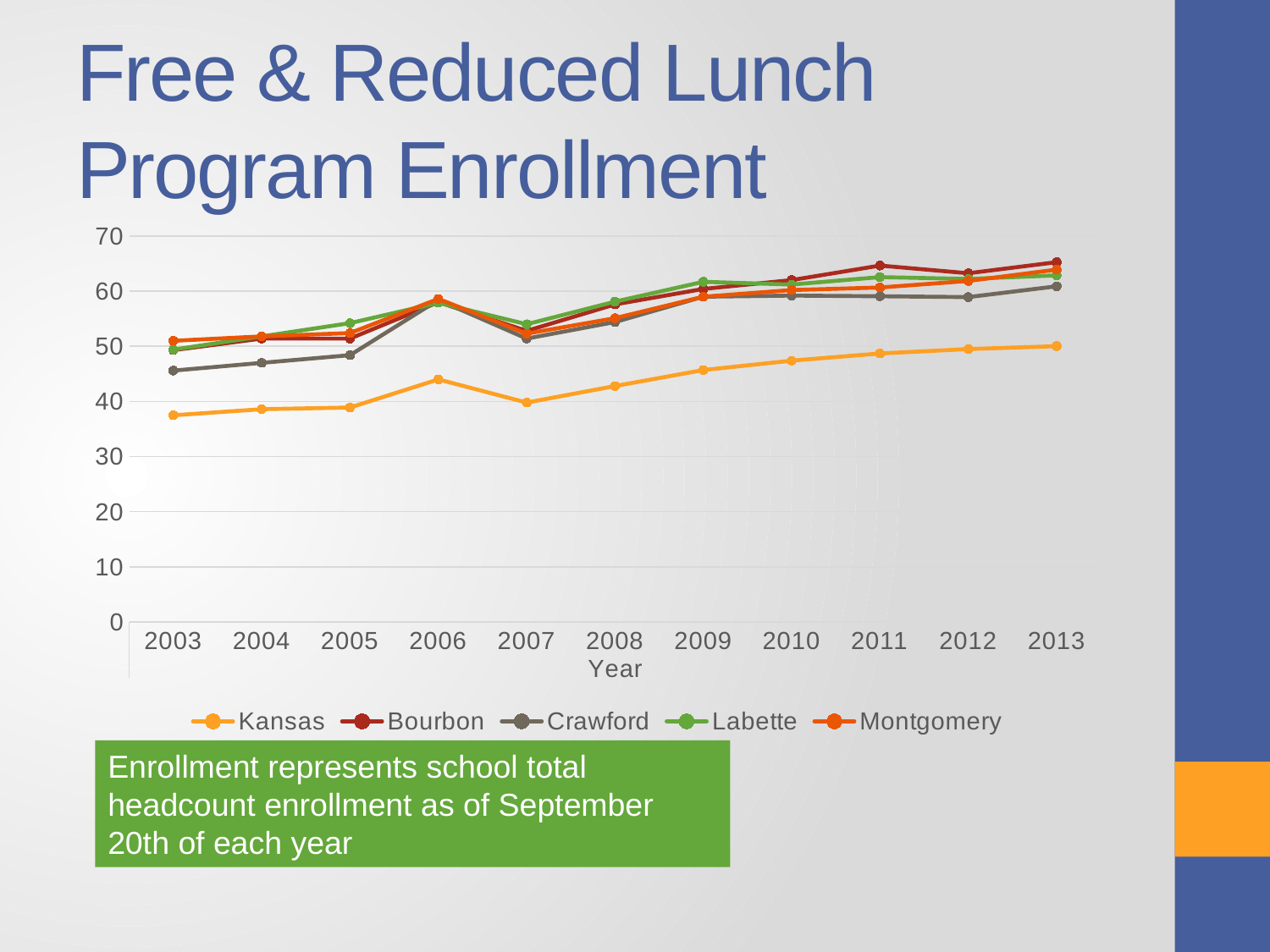
Is the value for Crawford in 2003 greater or less than 50? less What is the title of the x axis? Year Is the value for Kansas in 2003 greater or less than 40? less Which series has the lowest value in 2013? Kansas Which is larger in 2013, the value for Kansas or the value for Bourbon? Bourbon Is the value for Bourbon in 2013 greater or less than 60? greater How many series does the legend list? 5 Which series has the lowest value in 2003? Kansas Does the Kansas line generally rise or fall from 2003 to 2013? rise How many years are plotted along the x axis? 11 What kind of chart is shown on the slide? line chart